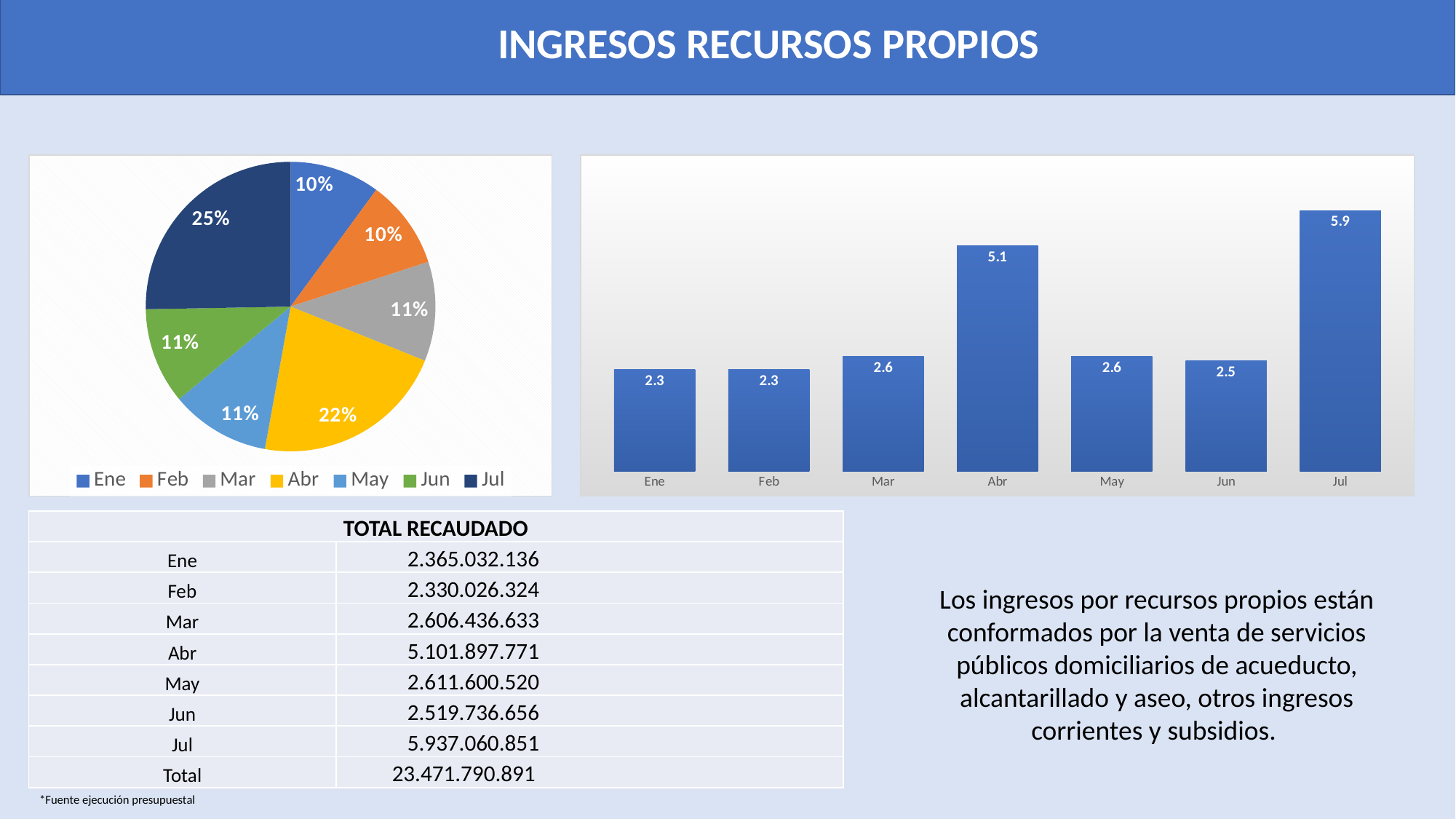
In the bar chart on the right, how many bars are plotted? 7 What kind of chart is shown on the right side of the slide? Bar chart In the pie chart on the left, what colour is the Abr slice? Yellow In the pie chart on the left, what share does Jul represent? 25% In the bar chart on the right, what is the value for Jul? 5.9 In the bar chart on the right, what is the value for Abr? 5.1 In the bar chart on the right, which month has the highest value? Jul In the pie chart on the left, which month has the largest slice? Jul In the pie chart on the left, how many entries does the legend list? 7 In the bar chart on the right, which is larger, the value for Mar or the value for Jun? Mar In the pie chart on the left, what share does Abr represent? 22% In the bar chart on the right, what is the difference between the values for Jul and Abr? 0.8